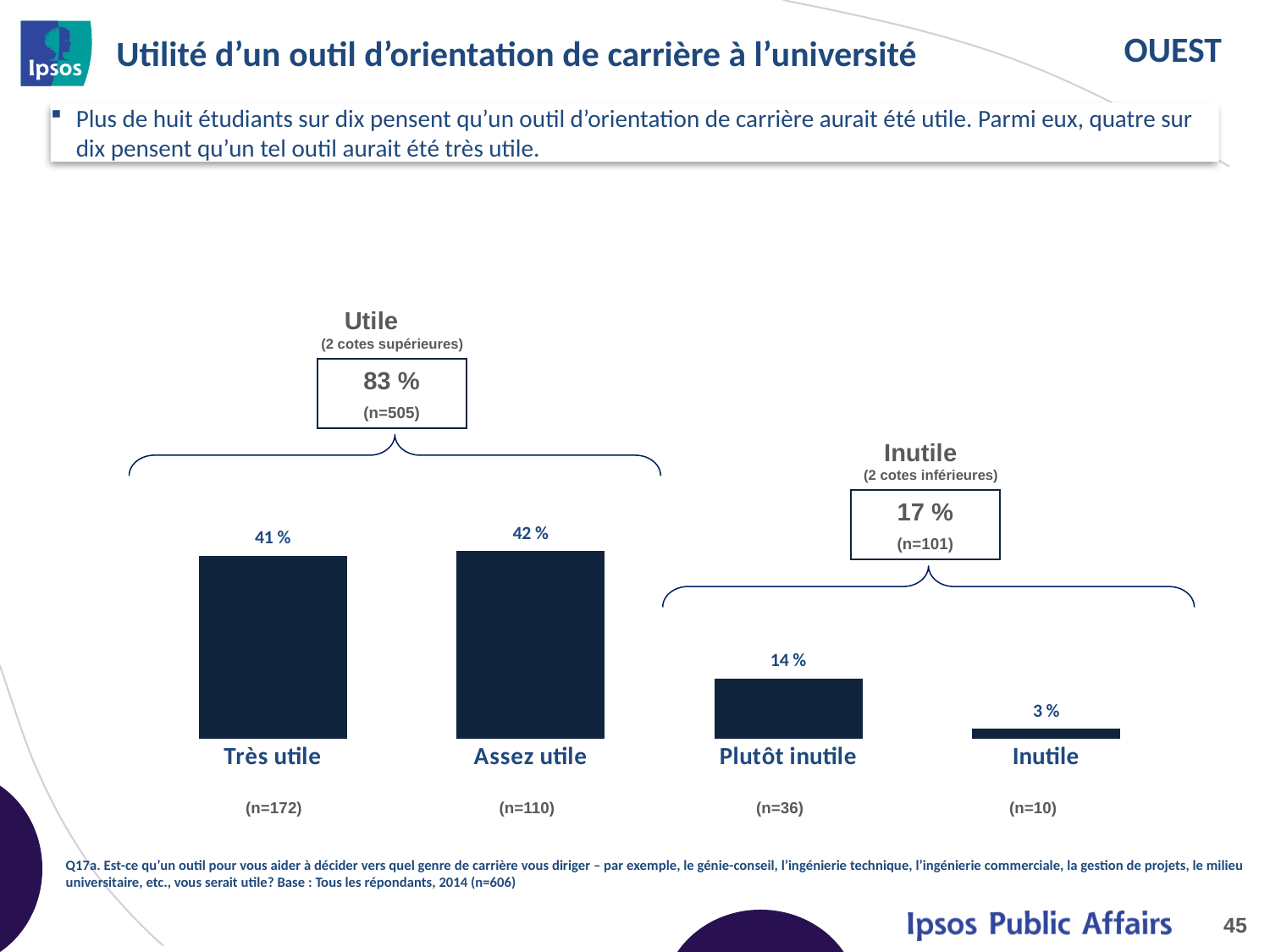
What combined percentage is shown in the "Inutile (2 cotes inférieures)" box? 17 % What value is shown for the "Inutile" bar? 3 % What is the difference between the "Assez utile" and "Plutôt inutile" values? 28 % Which category has the lowest value in the chart? Inutile What sample size (n) is shown under the "Plutôt inutile" bar? (n=36) What combined percentage is shown in the "Utile (2 cotes supérieures)" box? 83 % Which is larger, the value for "Très utile" or the value for "Plutôt inutile"? Très utile What value is shown for the "Très utile" bar? 41 % What kind of chart is shown on the slide? Bar chart How many categories are plotted in the bar chart? 4 What value is shown for the "Plutôt inutile" bar? 14 % What value is shown for the "Assez utile" bar? 42 %